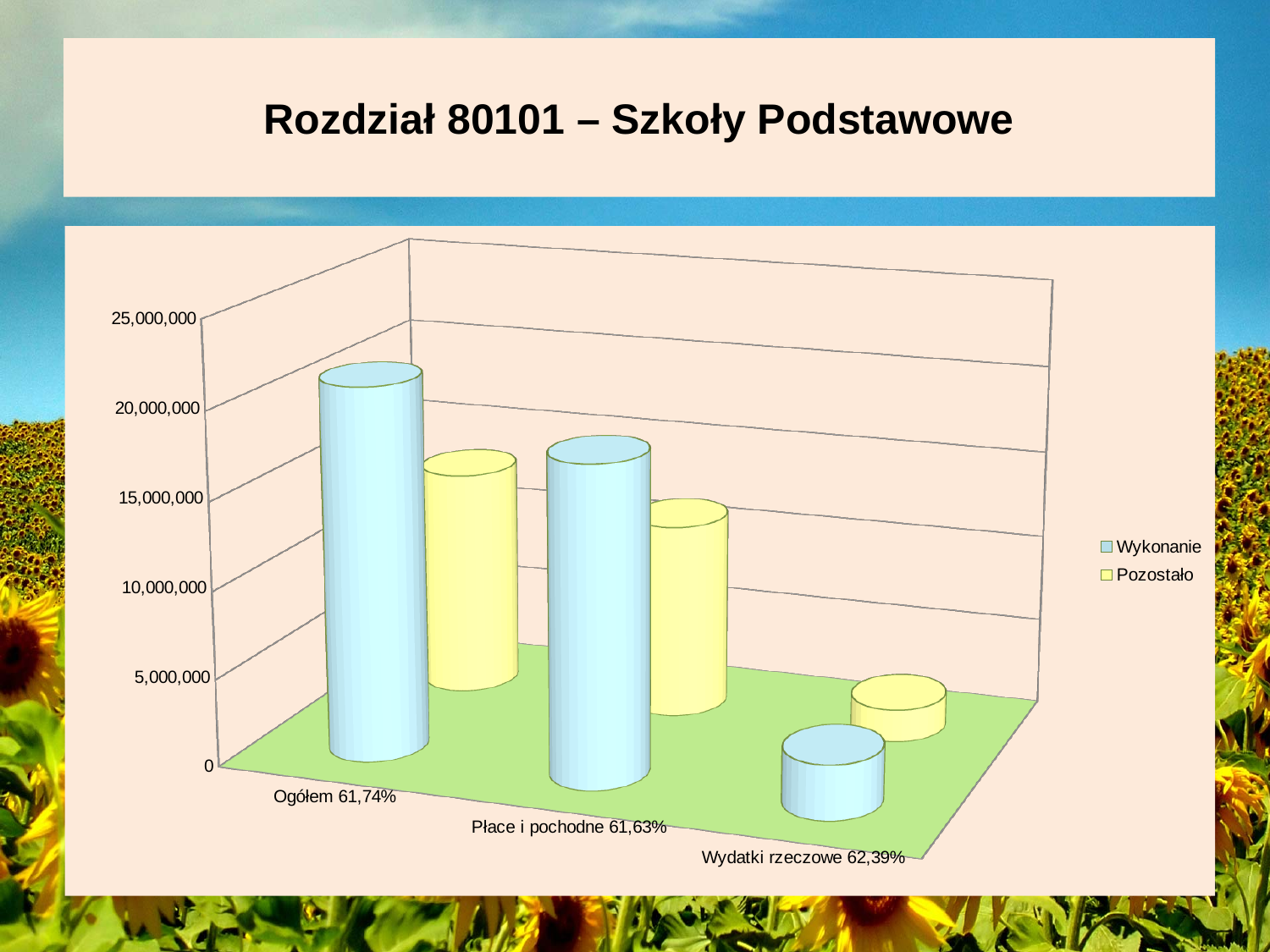
For Ogółem, which series has the larger value, Wykonanie or Pozostało? Wykonanie Which is larger: the Wykonanie value for Ogółem or the Wykonanie value for Płace i pochodne? Ogółem Which category has the tallest Wykonanie bar? Ogółem 61,74% Is the Wykonanie value for Płace i pochodne greater or less than 10,000,000? greater How many series does the legend list? 2 What is the title of the slide containing the chart? Rozdział 80101 – Szkoły Podstawowe What kind of chart is shown on the slide? Bar chart Which category has the lowest values for both series? Wydatki rzeczowe 62,39% Is the Wykonanie value for Wydatki rzeczowe greater or less than 5,000,000? less Is the Pozostało value for Ogółem greater or less than 5,000,000? greater How many categories are shown on the x axis? 3